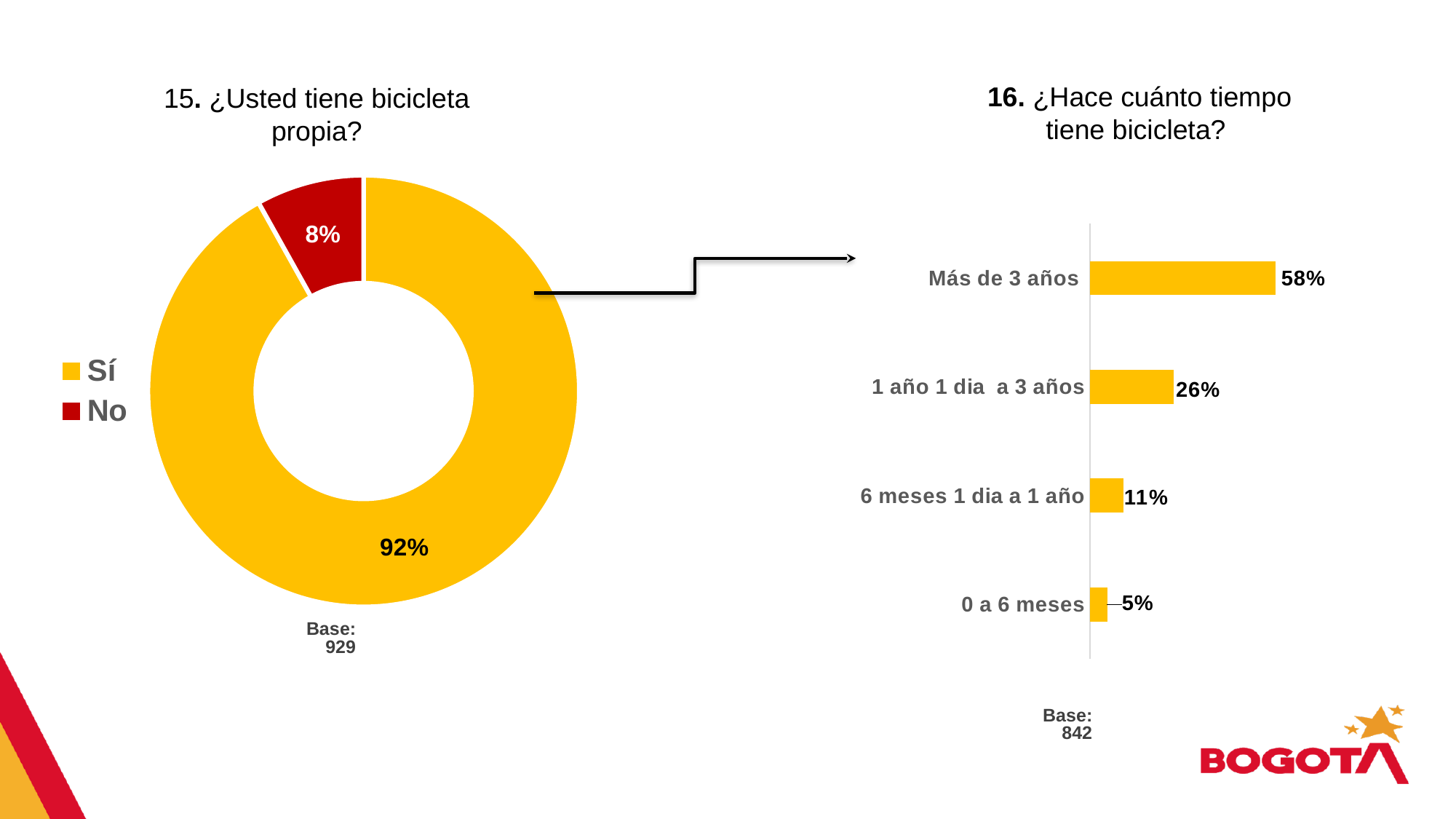
In the chart '16. ¿Hace cuánto tiempo tiene bicicleta?', what is the value for 'Más de 3 años'? 58% In the chart '16. ¿Hace cuánto tiempo tiene bicicleta?', which category has the highest value? Más de 3 años In the chart '16. ¿Hace cuánto tiempo tiene bicicleta?', how many categories are shown? 4 In the chart '15. ¿Usted tiene bicicleta propia?', how many entries does the legend list? 2 In the chart '16. ¿Hace cuánto tiempo tiene bicicleta?', which category has the lowest value? 0 a 6 meses In the chart '15. ¿Usted tiene bicicleta propia?', what is the difference between the Sí and No percentages? 84% In the chart '15. ¿Usted tiene bicicleta propia?', what percentage answered Sí? 92% In the chart '16. ¿Hace cuánto tiempo tiene bicicleta?', what kind of chart is shown? Bar chart In the chart '15. ¿Usted tiene bicicleta propia?', what percentage answered No? 8% In the chart '16. ¿Hace cuánto tiempo tiene bicicleta?', what is the value for '0 a 6 meses'? 5% In the chart '15. ¿Usted tiene bicicleta propia?', what kind of chart is shown? Doughnut chart In the chart '16. ¿Hace cuánto tiempo tiene bicicleta?', what is the difference between '1 año 1 dia a 3 años' and '6 meses 1 dia a 1 año'? 15%